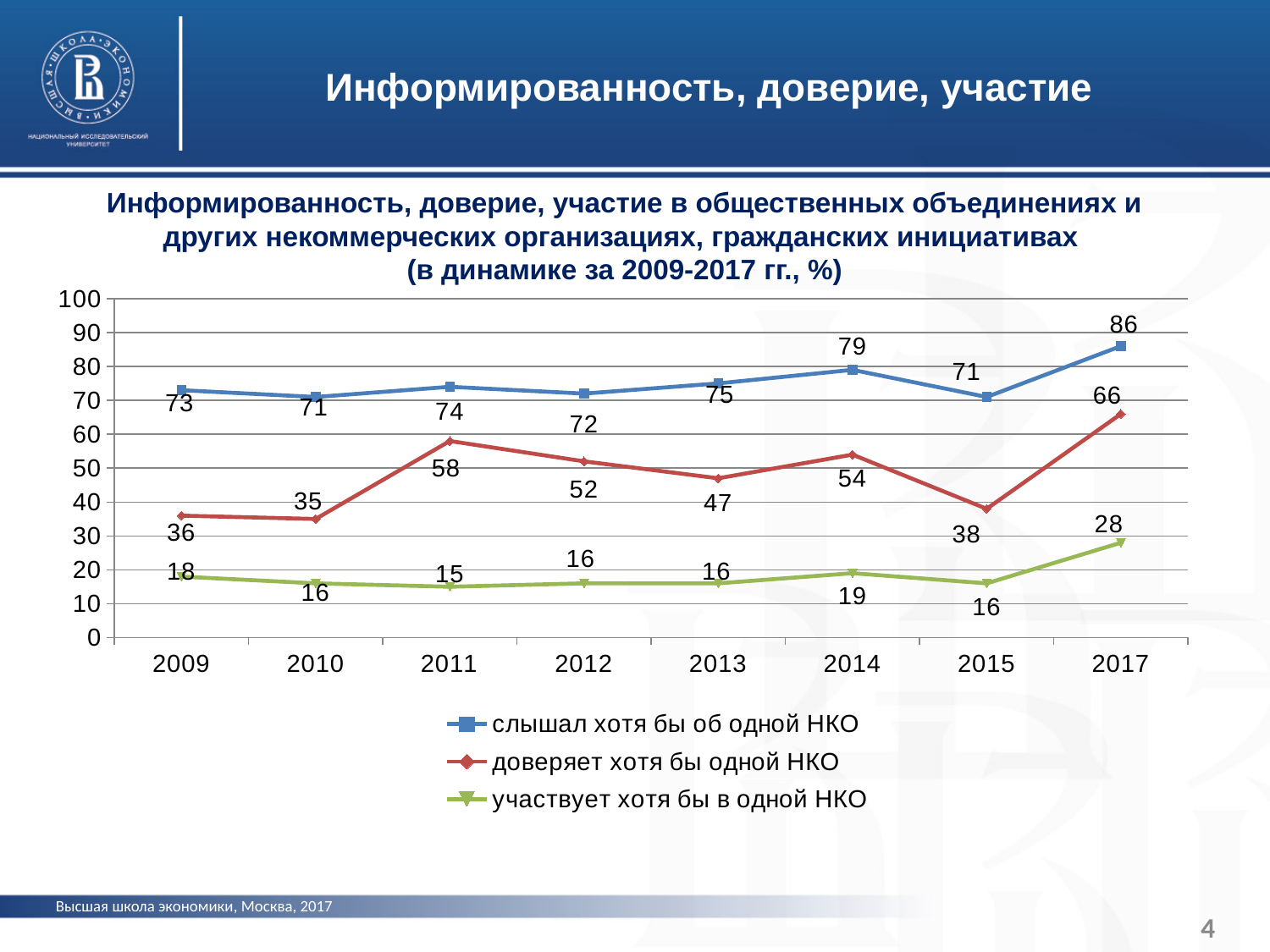
How many series does the legend list? 3 Does the value for "участвует хотя бы в одной НКО" rise or fall from 2015 to 2017? rise How many years are plotted along the x axis? 8 What kind of chart is shown on the slide? line chart What is the value for "участвует хотя бы в одной НКО" in 2017? 28 Which colour is used for the "слышал хотя бы об одной НКО" line? blue In which year is the value for "слышал хотя бы об одной НКО" highest? 2017 What is the value for "слышал хотя бы об одной НКО" in 2014? 79 What is the value for "доверяет хотя бы одной НКО" in 2011? 58 Which is larger in 2012: the value for "доверяет хотя бы одной НКО" or the value for "участвует хотя бы в одной НКО"? доверяет хотя бы одной НКО What is the difference between the 2017 and 2015 values for "доверяет хотя бы одной НКО"? 28 In which year is the value for "доверяет хотя бы одной НКО" lowest? 2010